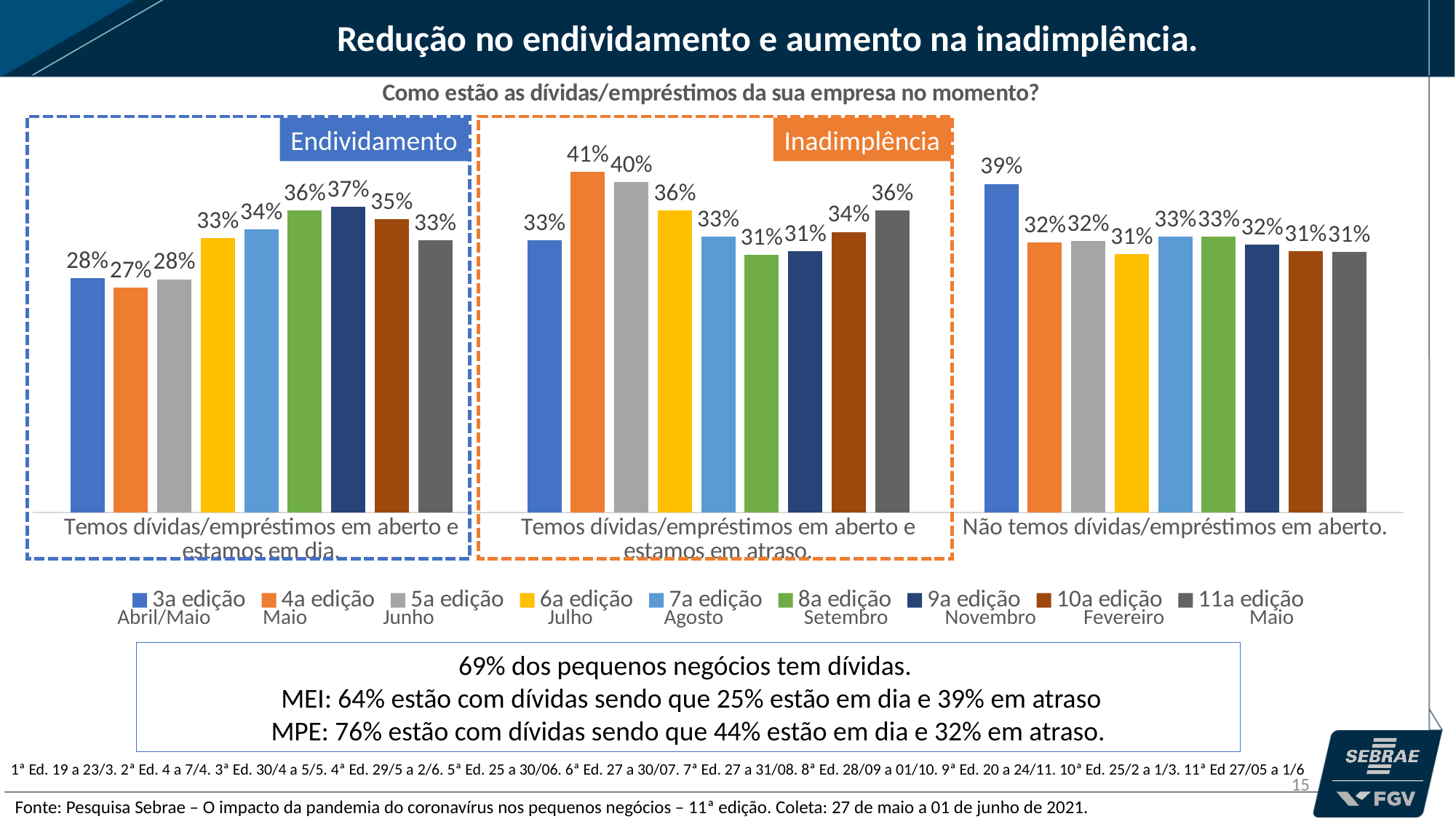
How many series does the chart legend list? 9 What is the value for the 4a edição series in the category "Temos dívidas/empréstimos em aberto e estamos em atraso"? 41% Which series has the highest value in the category "Temos dívidas/empréstimos em aberto e estamos em atraso"? 4a edição What is the value for the 11a edição series in the category "Temos dívidas/empréstimos em aberto e estamos em atraso"? 36% What is the value for the 9a edição series in the category "Temos dívidas/empréstimos em aberto e estamos em dia"? 37% How many categories are shown on the x axis of the chart? 3 Which series has the lowest value in the category "Temos dívidas/empréstimos em aberto e estamos em dia"? 4a edição What is the value for the 3a edição series in the category "Não temos dívidas/empréstimos em aberto."? 39% In the category "Não temos dívidas/empréstimos em aberto.", which is larger: the 3a edição value or the 11a edição value? 3a edição What is the difference between the 4a edição and 11a edição values in the category "Temos dívidas/empréstimos em aberto e estamos em atraso"? 5% What kind of chart is shown on the slide? Bar chart What is the difference between the 9a edição and 3a edição values in the category "Temos dívidas/empréstimos em aberto e estamos em dia"? 9%